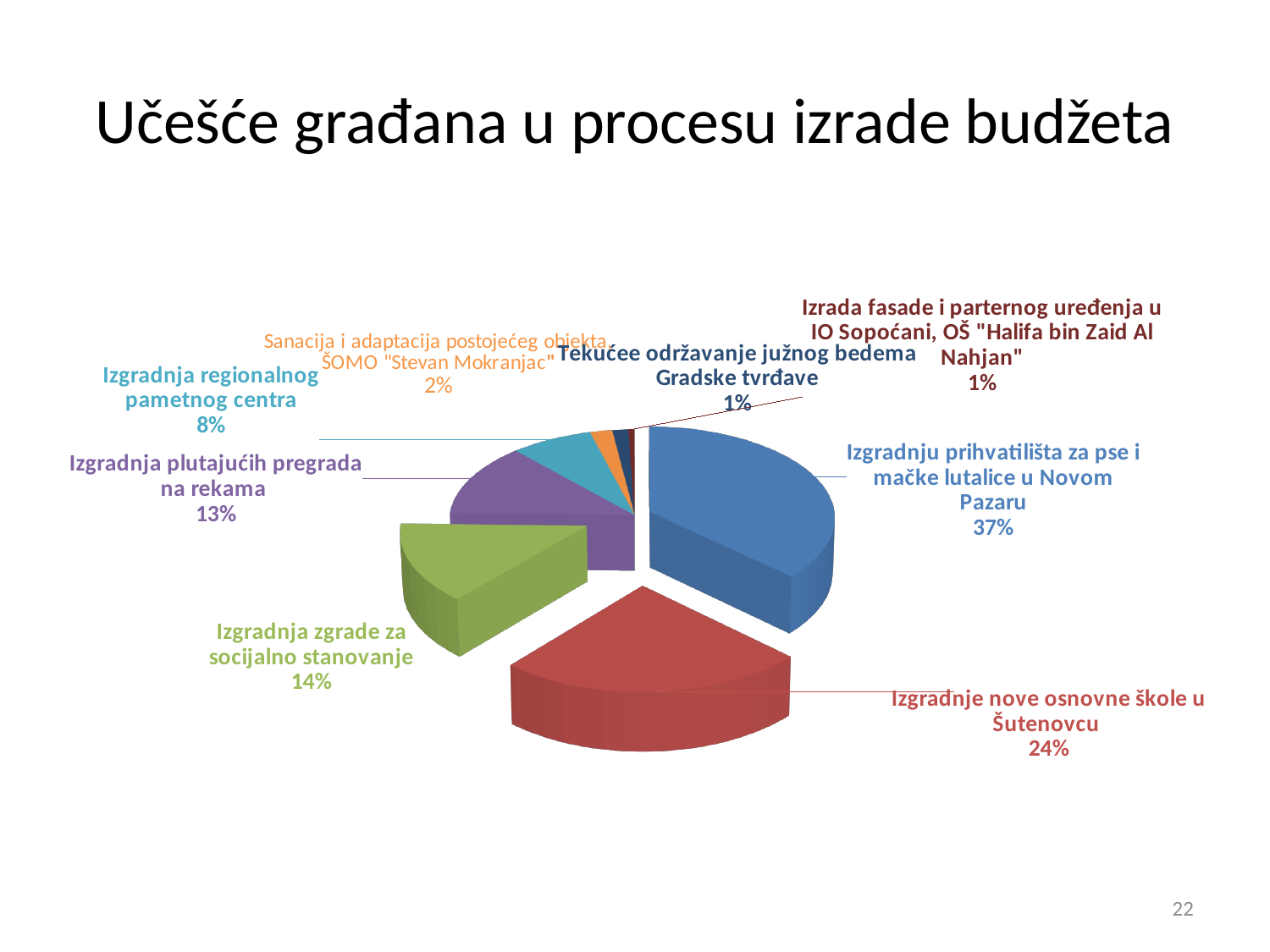
What share of the pie does "Izgradnja regionalnog pametnog centra" have? 8% What share of the pie does "Sanacija i adaptacija postojećeg objekta ŠOMO "Stevan Mokranjac"" have? 2% What share of the pie does "Izgradnje nove osnovne škole u Šutenovcu" have? 24% How many slices does the pie chart have? 8 What is the title of the slide containing the pie chart? Učešće građana u procesu izrade budžeta Which category has the largest share of the pie? Izgradnju prihvatilišta za pse i mačke lutalice u Novom Pazaru What is the difference in percentage points between "Izgradnju prihvatilišta za pse i mačke lutalice u Novom Pazaru" and "Izgradnje nove osnovne škole u Šutenovcu"? 13 What kind of chart is shown on the slide? pie chart Which has a larger share: "Izgradnja zgrade za socijalno stanovanje" or "Izgradnja regionalnog pametnog centra"? Izgradnja zgrade za socijalno stanovanje